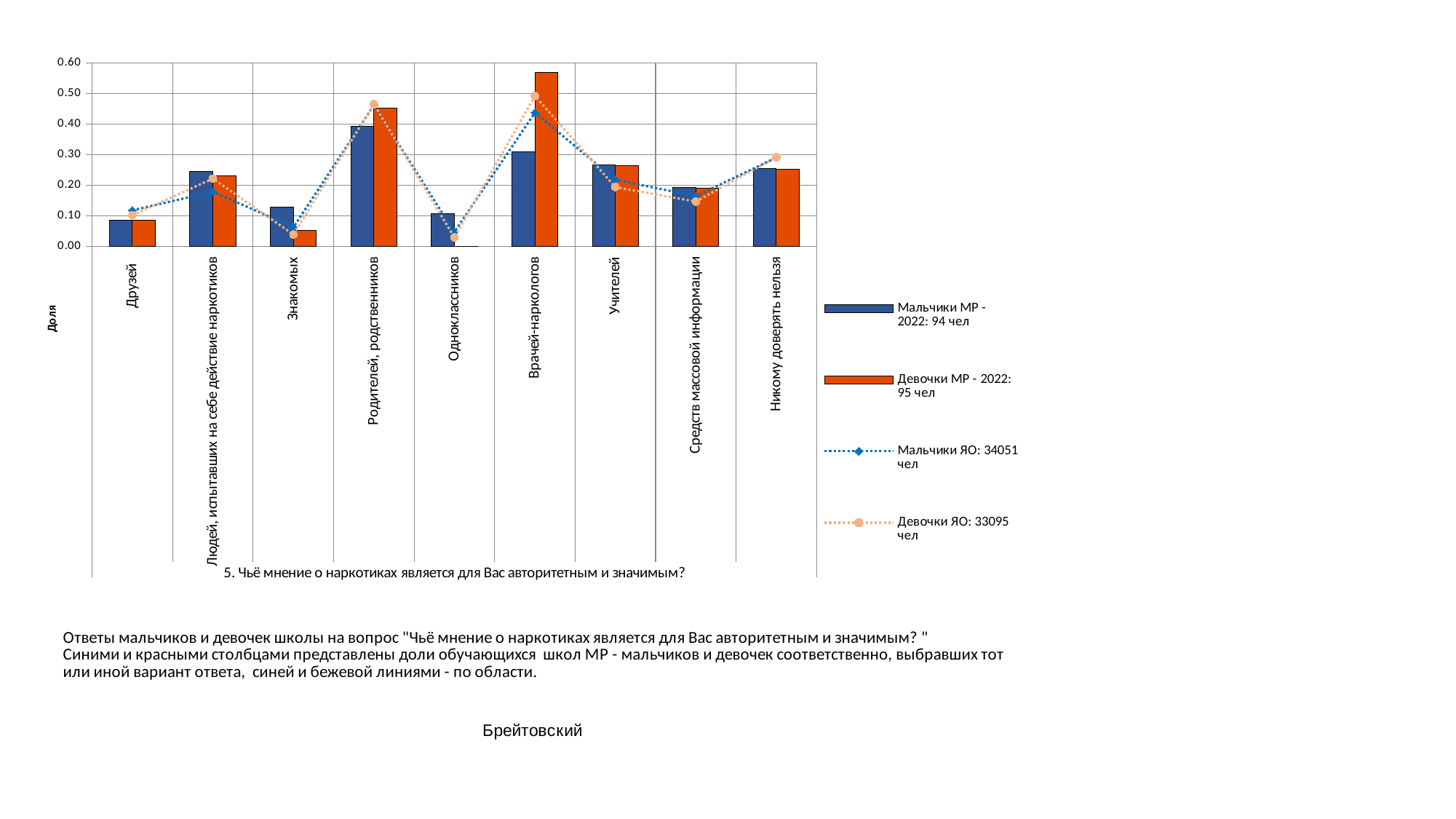
For the series Девочки МР - 2022, which category has the highest value? Врачей-наркологов What kind of chart is shown on the slide? Bar chart with line series What is the label of the vertical axis of the chart? Доля How many categories are shown on the x axis of the chart? 9 How many series does the chart's legend list? 4 For Врачей-наркологов, which bar is larger: Мальчики МР - 2022 or Девочки МР - 2022? Девочки МР - 2022 For the series Мальчики МР - 2022, which category has the highest value? Родителей, родственников For the series Девочки МР - 2022, which category has the lowest value? Одноклассников Is the value for Никому доверять нельзя in the series Мальчики МР - 2022 greater or less than 0.20? greater For Знакомых, which bar is larger: Мальчики МР - 2022 or Девочки МР - 2022? Мальчики МР - 2022 Is the value for Врачей-наркологов in the series Девочки МР - 2022 greater or less than 0.50? greater Is the value for Знакомых in the series Девочки МР - 2022 greater or less than 0.10? less